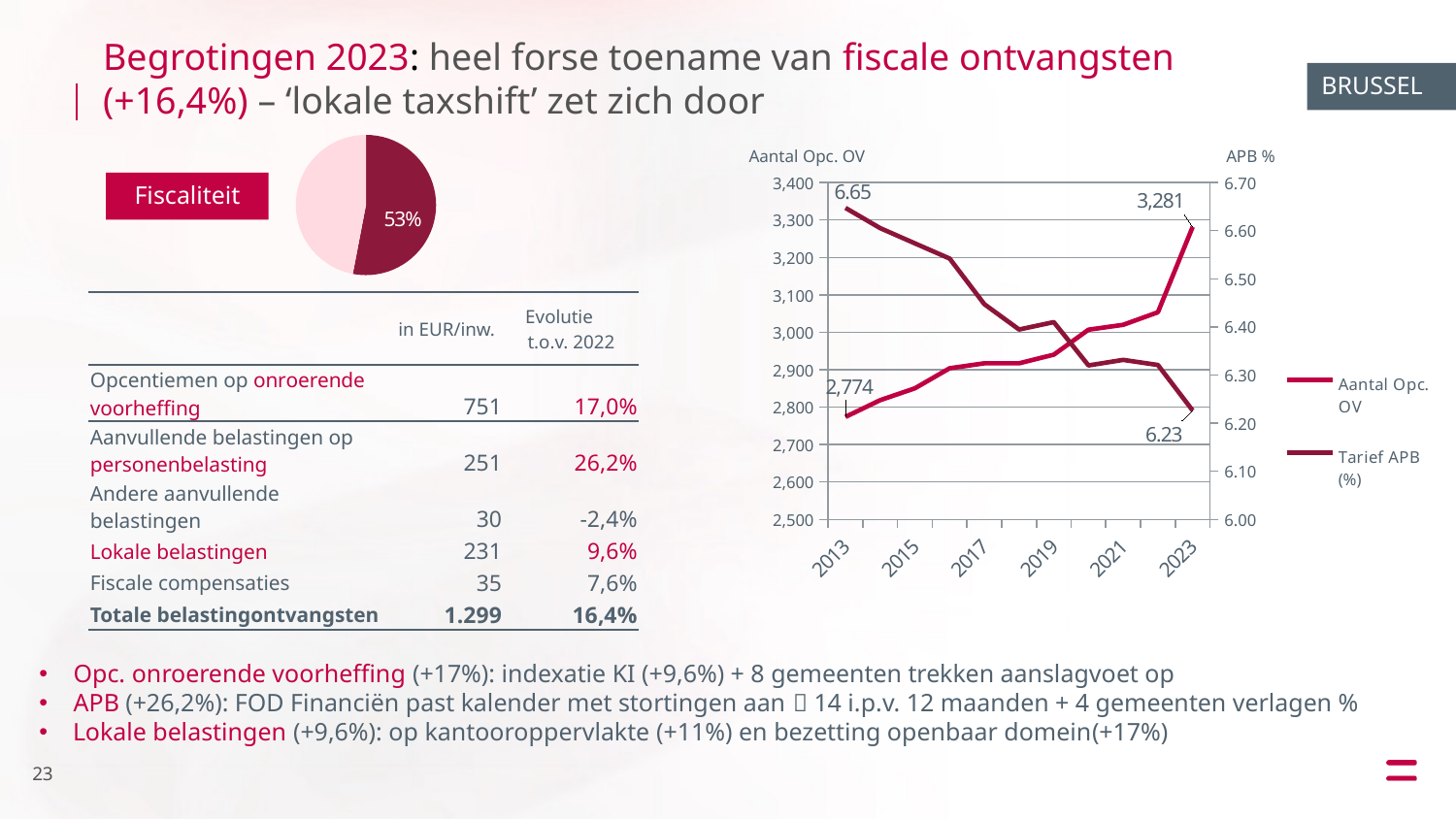
On the line chart, does Aantal Opc. OV rise or fall from 2013 to 2023? rise How many series does the legend of the line chart list? 2 On the pie chart next to 'Fiscaliteit', what share is shown for the dark red slice? 53% On the line chart, is the value of Aantal Opc. OV in 2019 greater or less than 3,100? less On the line chart, does the Tarief APB (%) rise or fall from 2013 to 2023? fall On the line chart, is the Tarief APB (%) in 2017 greater or less than 6.40? greater What kind of chart is the chart on the right of the slide? line chart On the line chart, by how much did Aantal Opc. OV increase from 2013 to 2023? 507 On the line chart, what is the Tarief APB (%) in 2023? 6.23 On the line chart, what is the value of Aantal Opc. OV in 2023? 3,281 On the line chart, what is the Tarief APB (%) in 2013? 6.65 On the line chart, what is the value of Aantal Opc. OV in 2013? 2,774